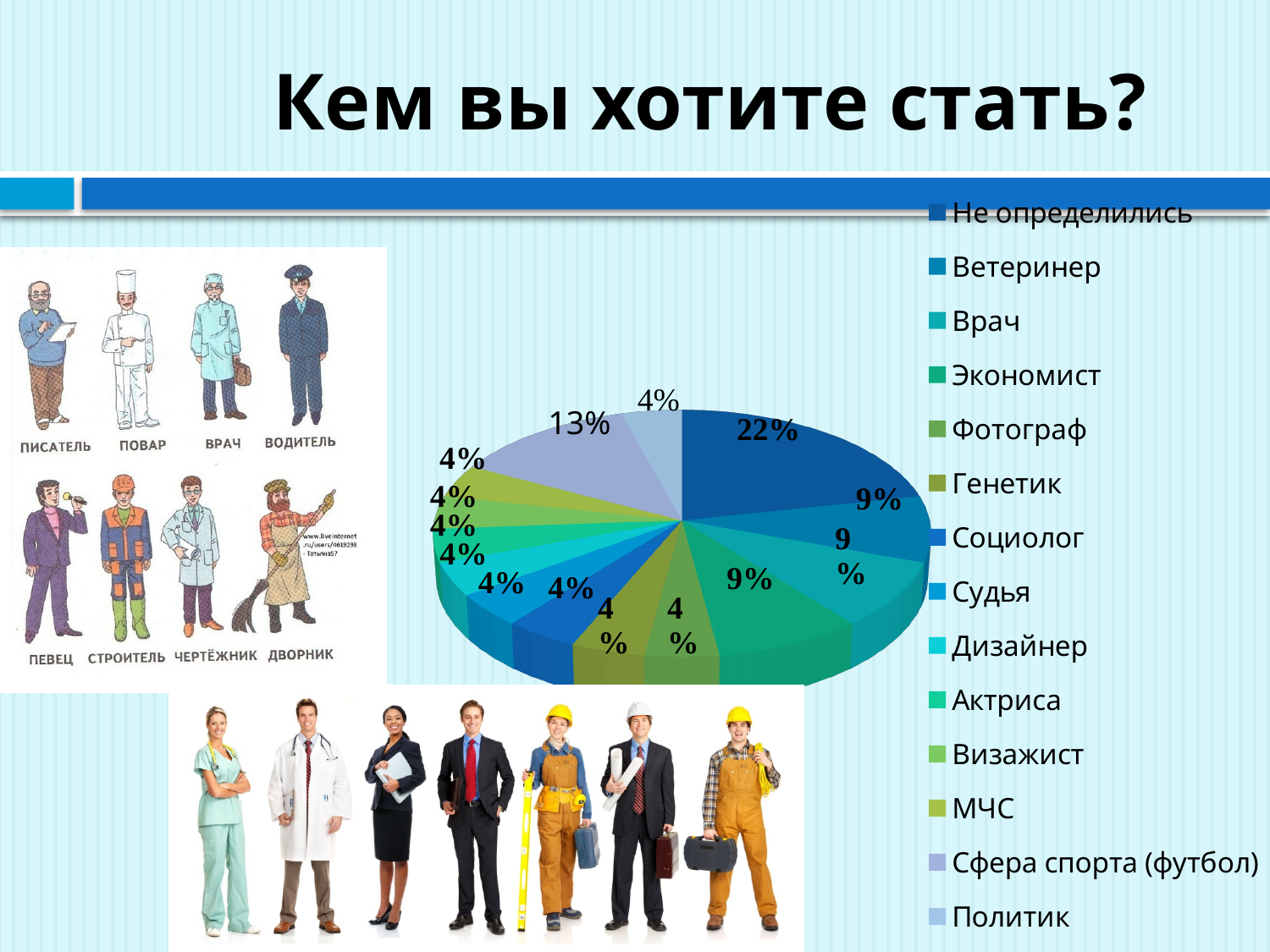
Which category has the largest slice of the pie chart? Не определились Which legend entry is listed first in the pie chart's legend? Не определились What is the difference in percentage points between 'Не определились' (22%) and 'Сфера спорта (футбол)' (13%)? 9 What is the value shown for 'Ветеринер'? 9% What share of the pie does 'Сфера спорта (футбол)' have? 13% What is the value shown for 'Политик'? 4% Which is larger, the slice for 'Сфера спорта (футбол)' or the slice for 'Политик'? Сфера спорта (футбол) What share of the pie does 'Не определились' have? 22% Which is larger, the slice for 'Не определились' or the slice for 'Сфера спорта (футбол)'? Не определились What is the title of the slide with the pie chart? Кем вы хотите стать? How many categories does the legend of the pie chart list? 14 What kind of chart is shown on the slide? pie chart